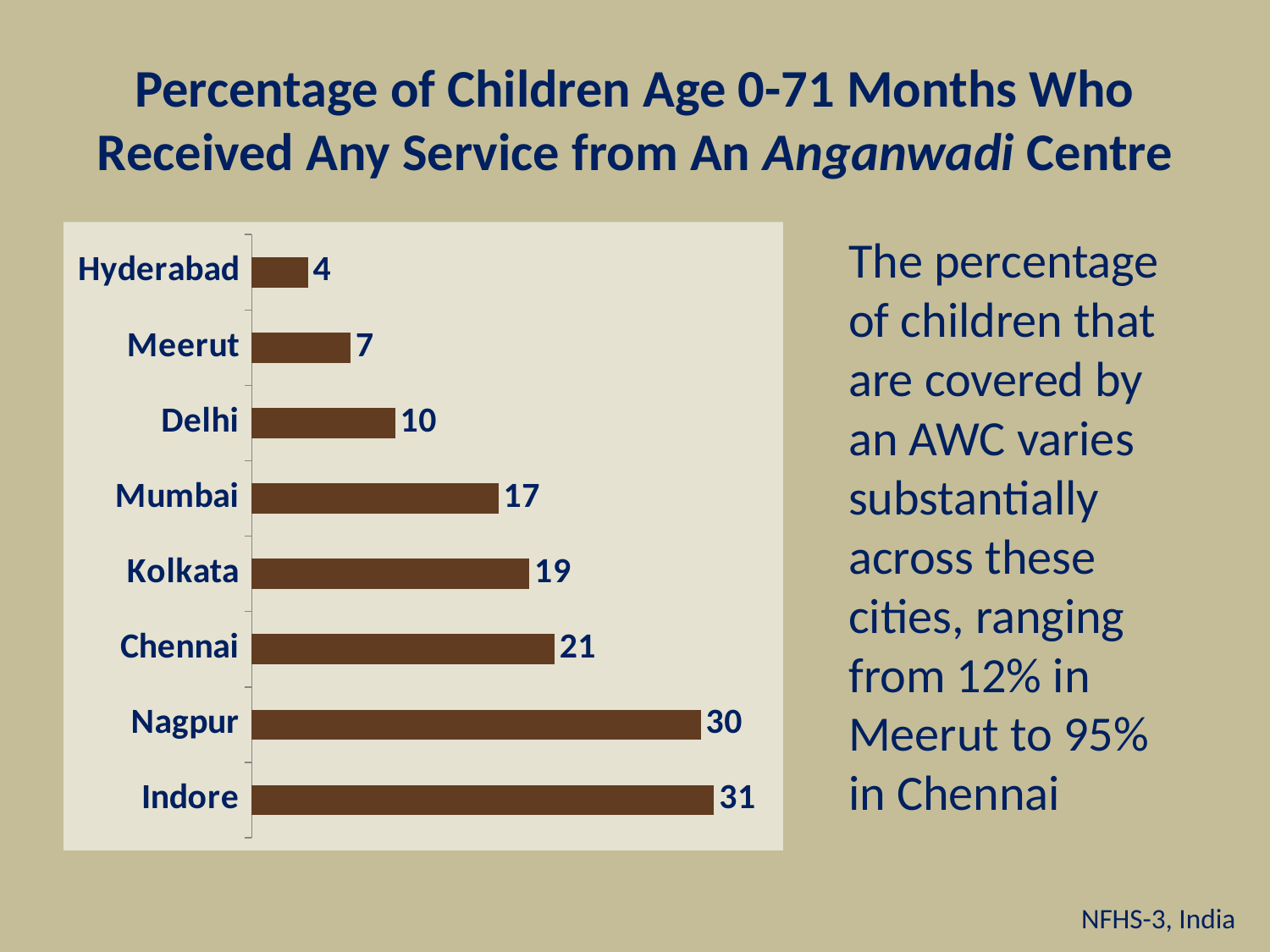
What is the value for Mumbai? 17 Which city has the highest value? Indore What is the difference between the values for Chennai and Hyderabad? 17 How many cities are shown in the chart? 8 Which is larger, the value for Kolkata or the value for Meerut? Kolkata Which city has the lowest value? Hyderabad What kind of chart is shown on the slide? Bar chart What is the value for Indore? 31 What is the difference between the values for Nagpur and Delhi? 20 What is the value for Hyderabad? 4 What colour are the bars in the chart? Brown What is the value for Nagpur? 30